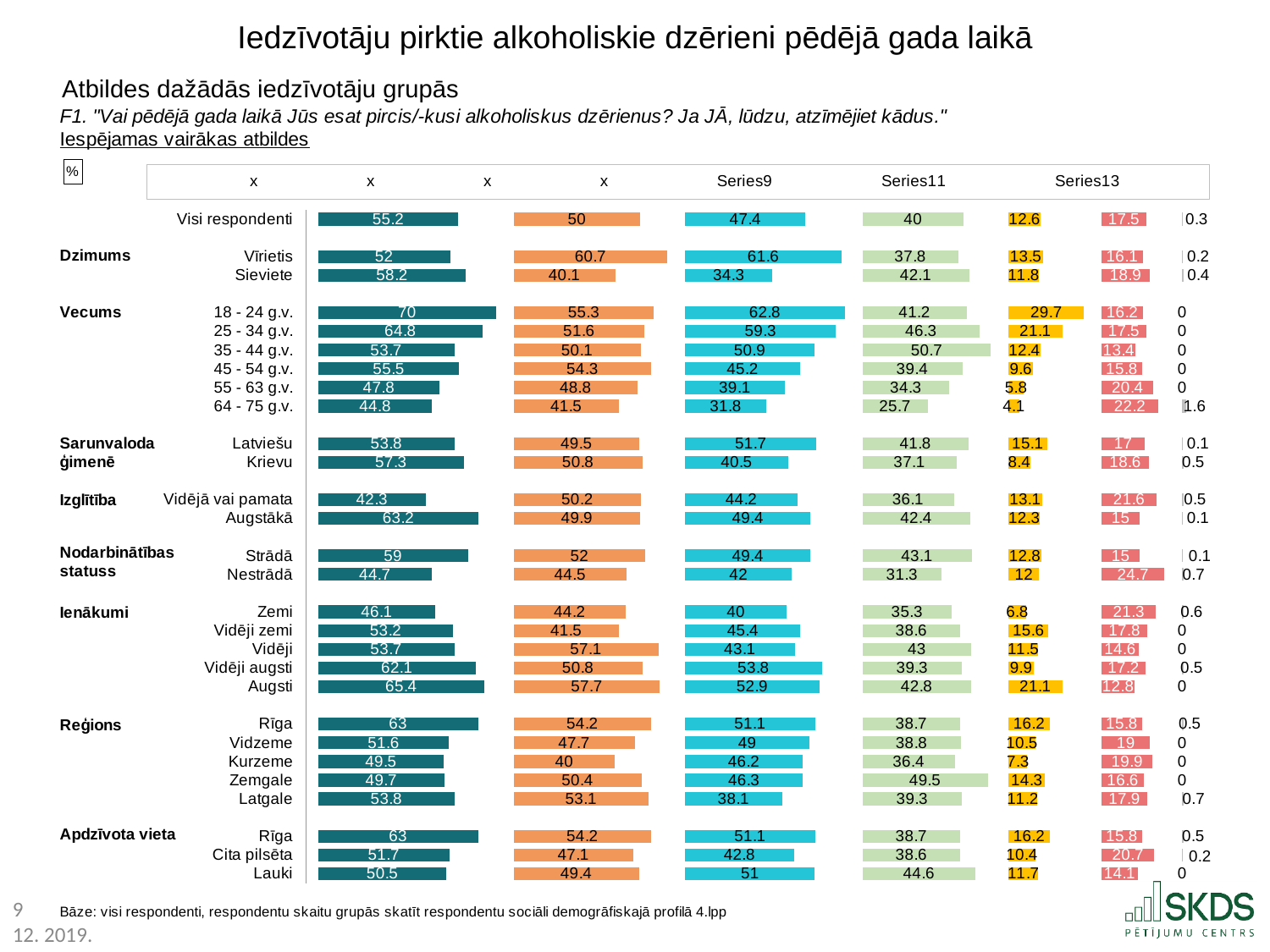
How many categories are listed under Reģions? 5 What is the value of the first (dark teal) series for the 18 - 24 g.v. group? 70 What is the value of the fourth (light green) series for Zemgale? 49.5 What is the value of the fifth (yellow) series for the Augsti income group? 21.1 What is the value of the first (dark teal) series for Visi respondenti? 55.2 Among the Reģions categories, which has the highest value in the first (dark teal) series? Rīga In the second (orange) series, what is the difference between the values for Vīrietis and Sieviete? 20.6 Among the Vecums (age) groups, which has the highest value in the first (dark teal) series? 18 - 24 g.v. In the third (cyan) series, which is larger: the value for Vīrietis or for Sieviete? Vīrietis Among the Vecums (age) groups, which has the lowest value in the first (dark teal) series? 64 - 75 g.v. What kind of chart is shown on the slide? bar chart How many series does the legend list? 7